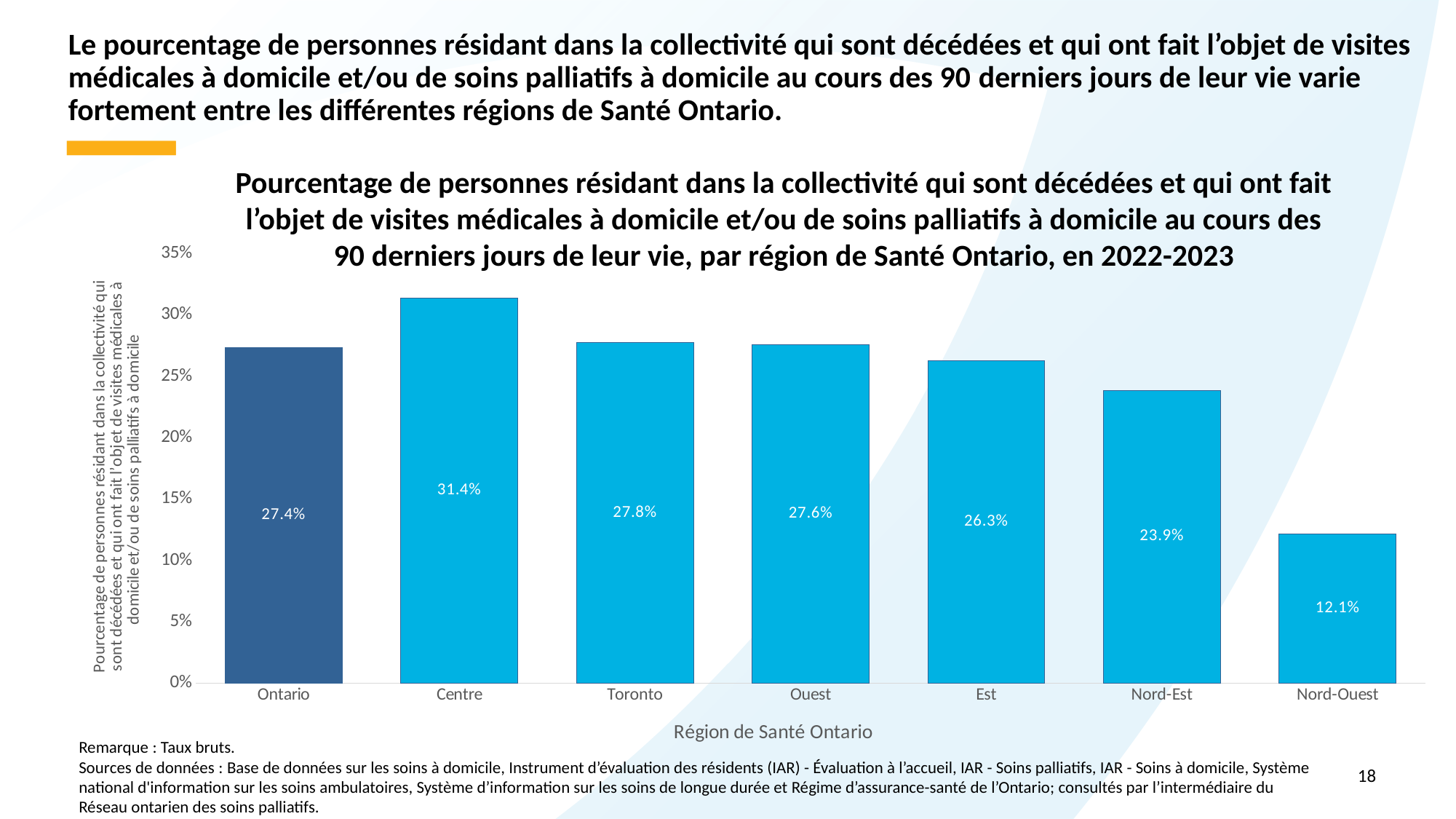
Which region has the highest value? Centre Which region has the lowest value? Nord-Ouest What is the x-axis title of the chart? Région de Santé Ontario How many regions are shown on the x axis? 7 Which is larger, the value for Est or the value for Nord-Est? Est What is the difference between the values for Centre and Nord-Ouest? 19.3% What is the value for Nord-Ouest? 12.1% What is the value for Nord-Est? 23.9% What is the difference between the values for Toronto and Est? 1.5% What is the value for Ontario? 27.4% What is the value for Centre? 31.4% What kind of chart is this? Bar chart